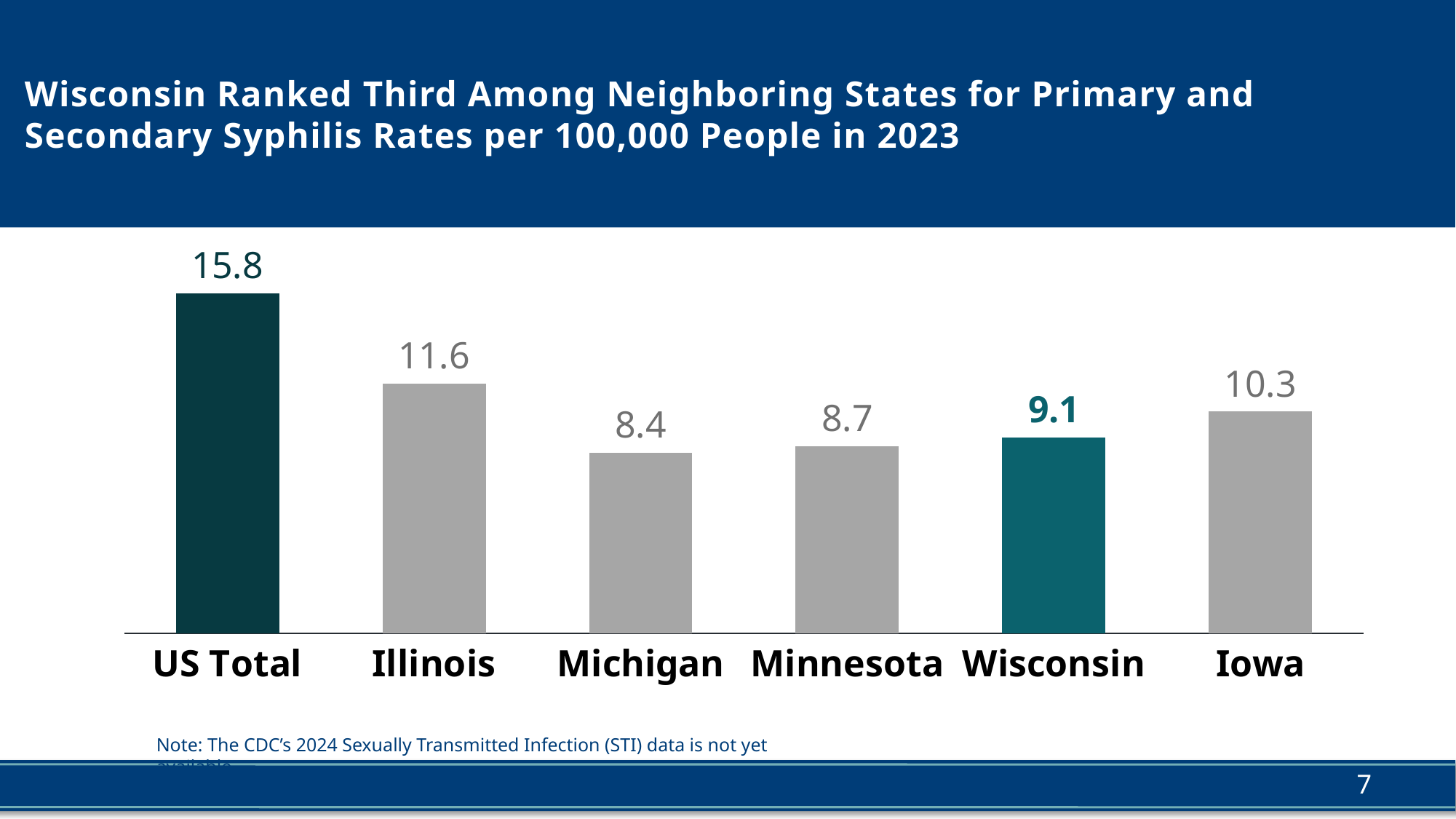
What is the difference between the Illinois value and the Iowa value? 1.3 What is the difference between the US Total value and the Wisconsin value? 6.7 Which category has the highest value? US Total Which category has the lowest value? Michigan What is the value shown for Iowa? 10.3 What is the value shown for US Total? 15.8 What is the value shown for Illinois? 11.6 How many bars are shown in the chart? 6 Which has a larger value, Minnesota or Michigan? Minnesota What type of chart is shown on the slide? Bar chart What is the primary and secondary syphilis rate per 100,000 people for Wisconsin? 9.1 Which bar is shown in a teal color that differs from the gray state bars? Wisconsin